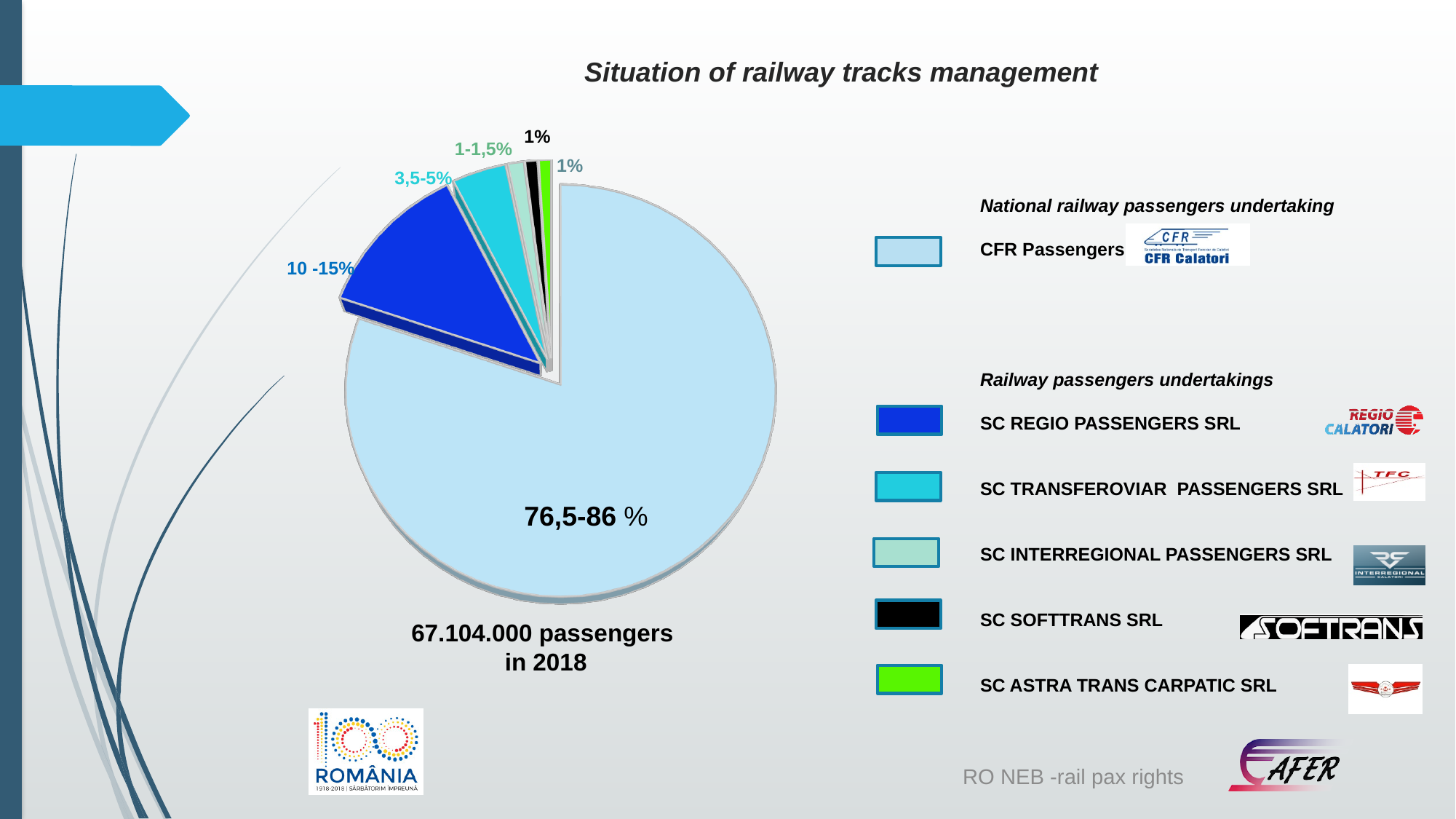
What share of the pie is labelled for CFR Passengers? 76,5-86 % What share of the pie is labelled for SC SOFTTRANS SRL? 1% How many passengers in 2018 does the text under the pie chart state? 67.104.000 passengers Which undertaking has the largest slice of the pie? CFR Passengers What share of the pie is labelled for SC REGIO PASSENGERS SRL? 10 -15% Which slice is larger, SC REGIO PASSENGERS SRL or SC TRANSFEROVIAR PASSENGERS SRL? SC REGIO PASSENGERS SRL What kind of chart is shown on the slide? pie chart How many undertakings are listed in the legend? 6 What share of the pie is labelled for SC INTERREGIONAL PASSENGERS SRL? 1-1,5% How many slices does the pie chart have? 6 What is the title of the slide? Situation of railway tracks management What share of the pie is labelled for SC TRANSFEROVIAR PASSENGERS SRL? 3,5-5%